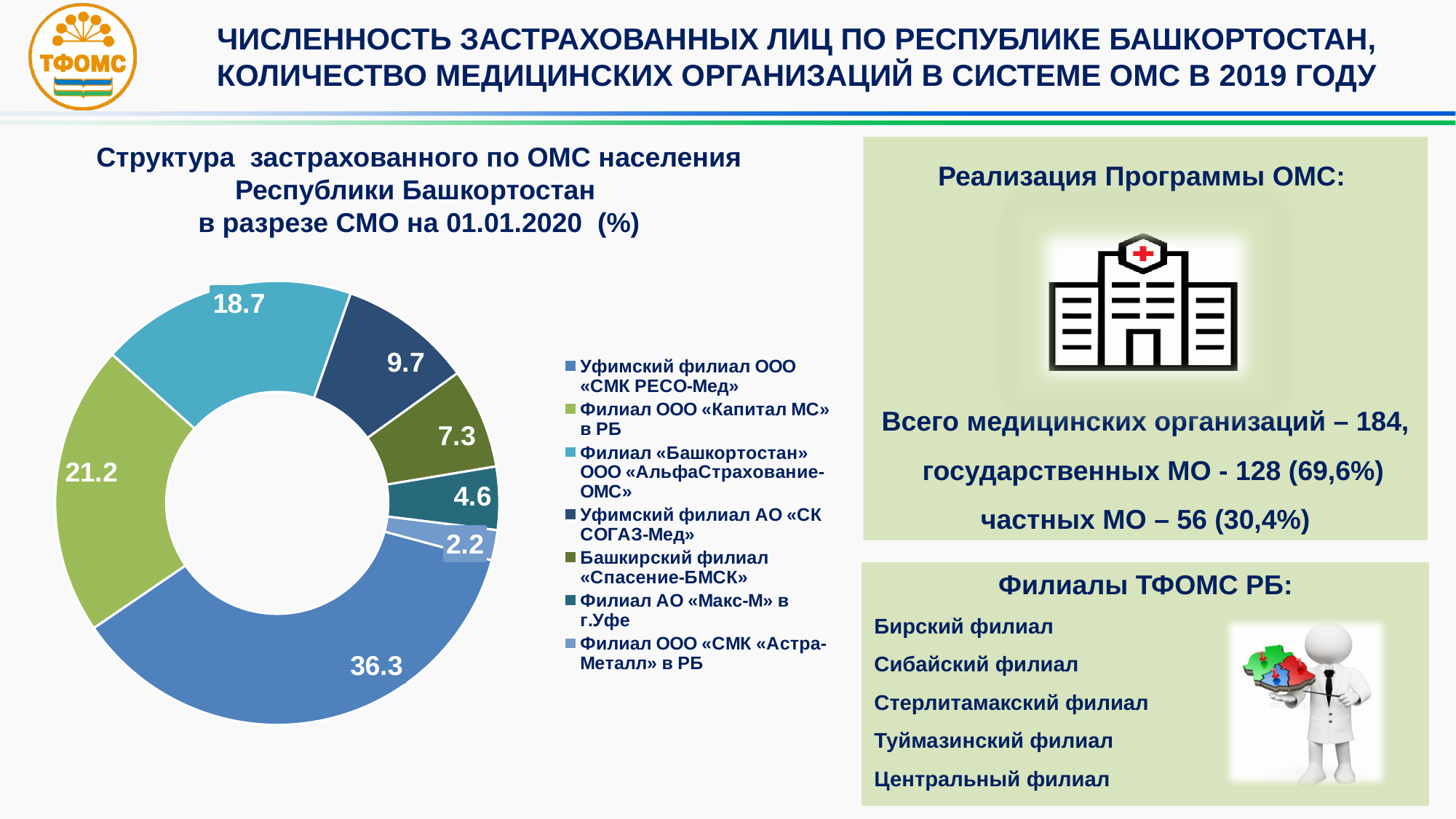
How many slices does the pie chart have? 7 What share does Филиал ООО «Капитал МС» в РБ have in the pie chart? 21.2 Which is larger: the share of Филиал АО «Макс-М» в г.Уфе or the share of Башкирский филиал «Спасение-БМСК»? Башкирский филиал «Спасение-БМСК» What share does Уфимский филиал ООО «СМК РЕСО-Мед» have in the pie chart? 36.3 How many entries does the legend of the pie chart list? 7 What value is shown for Филиал «Башкортостан» ООО «АльфаСтрахование-ОМС»? 18.7 What is the difference between the shares of Уфимский филиал АО «СК СОГАЗ-Мед» and Башкирский филиал «Спасение-БМСК»? 2.4 Which insurer has the smallest share in the pie chart? Филиал ООО «СМК «Астра-Металл» в РБ What is the combined share of Уфимский филиал ООО «СМК РЕСО-Мед» and Филиал ООО «Капитал МС» в РБ? 57.5 What type of chart is shown on the slide? doughnut (pie) chart What value is shown for Филиал ООО «СМК «Астра-Металл» в РБ? 2.2 Which insurer has the largest share in the pie chart? Уфимский филиал ООО «СМК РЕСО-Мед»